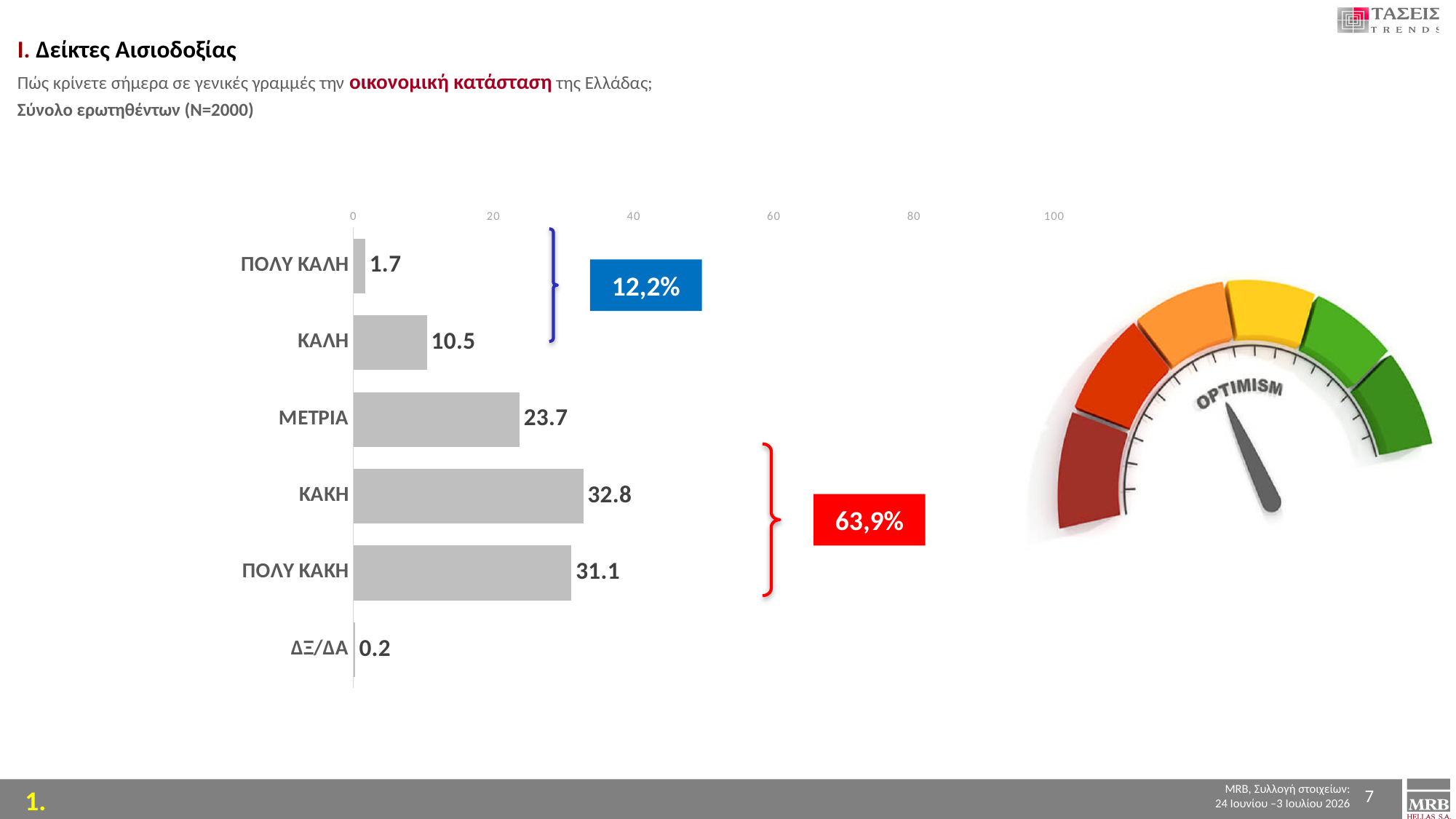
What is the value for ΠΟΛΥ ΚΑΛΗ? 1.7 Is the value for ΠΟΛΥ ΚΑΚΗ greater or less than 20? greater What is the value for ΔΞ/ΔΑ? 0.2 What is the value for ΚΑΚΗ? 32.8 Which category has the highest value? ΚΑΚΗ Which category has the lowest value? ΔΞ/ΔΑ What percentage is shown in the red box next to the bracket grouping ΚΑΚΗ and ΠΟΛΥ ΚΑΚΗ? 63,9% How many categories are shown in the bar chart? 6 What kind of chart is shown on the slide? bar chart Which is larger, the value for ΚΑΛΗ or the value for ΜΕΤΡΙΑ? ΜΕΤΡΙΑ What is the difference between the values for ΚΑΚΗ and ΠΟΛΥ ΚΑΚΗ? 1.7 What is the value for ΜΕΤΡΙΑ? 23.7